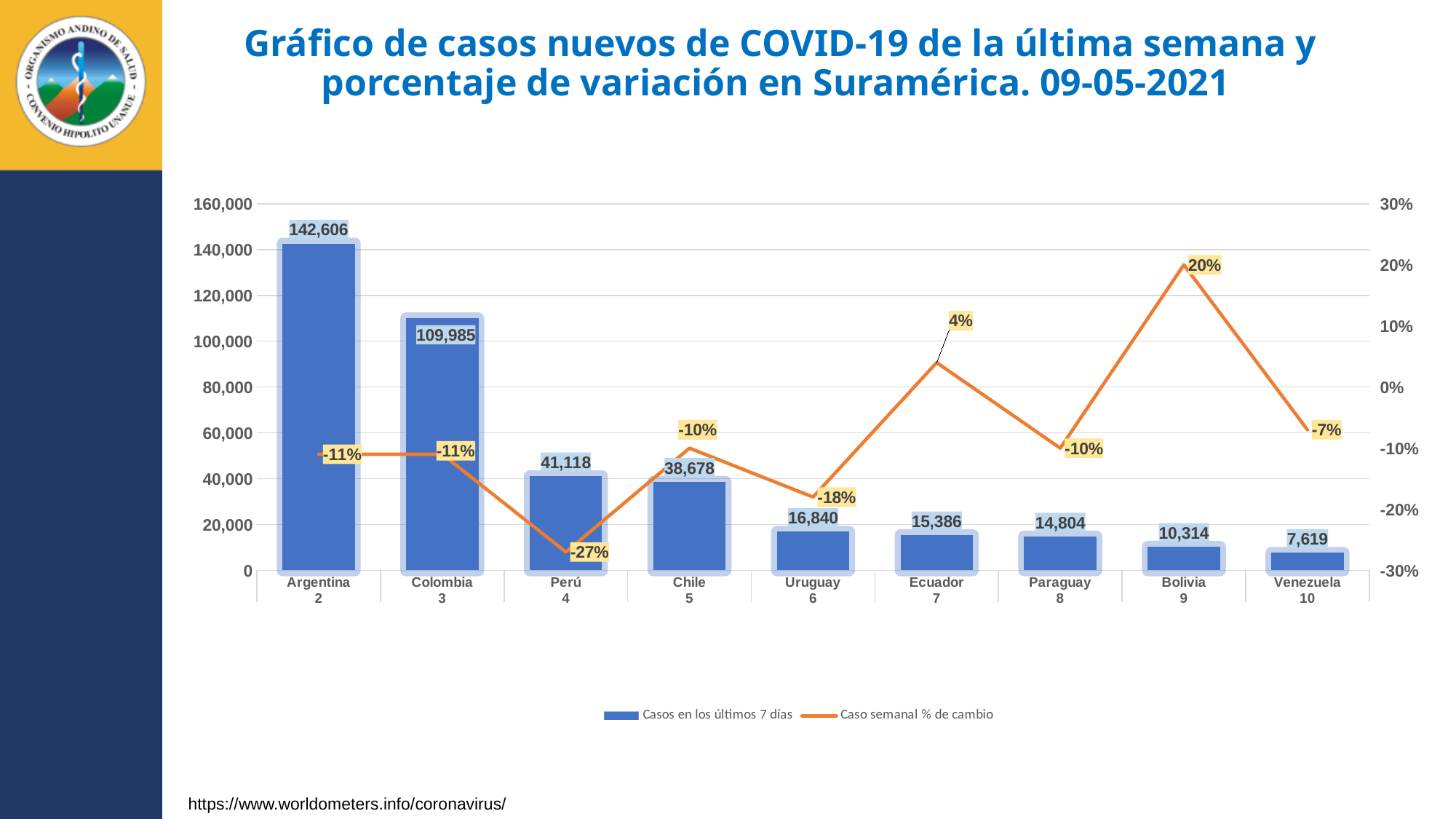
Which has more cases in the last 7 days, Chile or Perú? Perú What is the weekly percentage change shown for Bolivia? 20% How many new COVID-19 cases in the last 7 days are shown for Argentina? 142,606 Which country has the lowest weekly percentage change? Perú What is the difference in cases in the last 7 days between Argentina and Colombia? 32,621 How many countries are shown on the chart? 9 What is the weekly percentage change shown for Perú? -27% What kind of chart is used to show the cases in the last 7 days? Bar chart Which country has the lowest number of cases in the last 7 days? Venezuela How many series does the legend list? 2 What colour is the line showing the weekly percentage change? Orange Which country has the highest number of cases in the last 7 days? Argentina